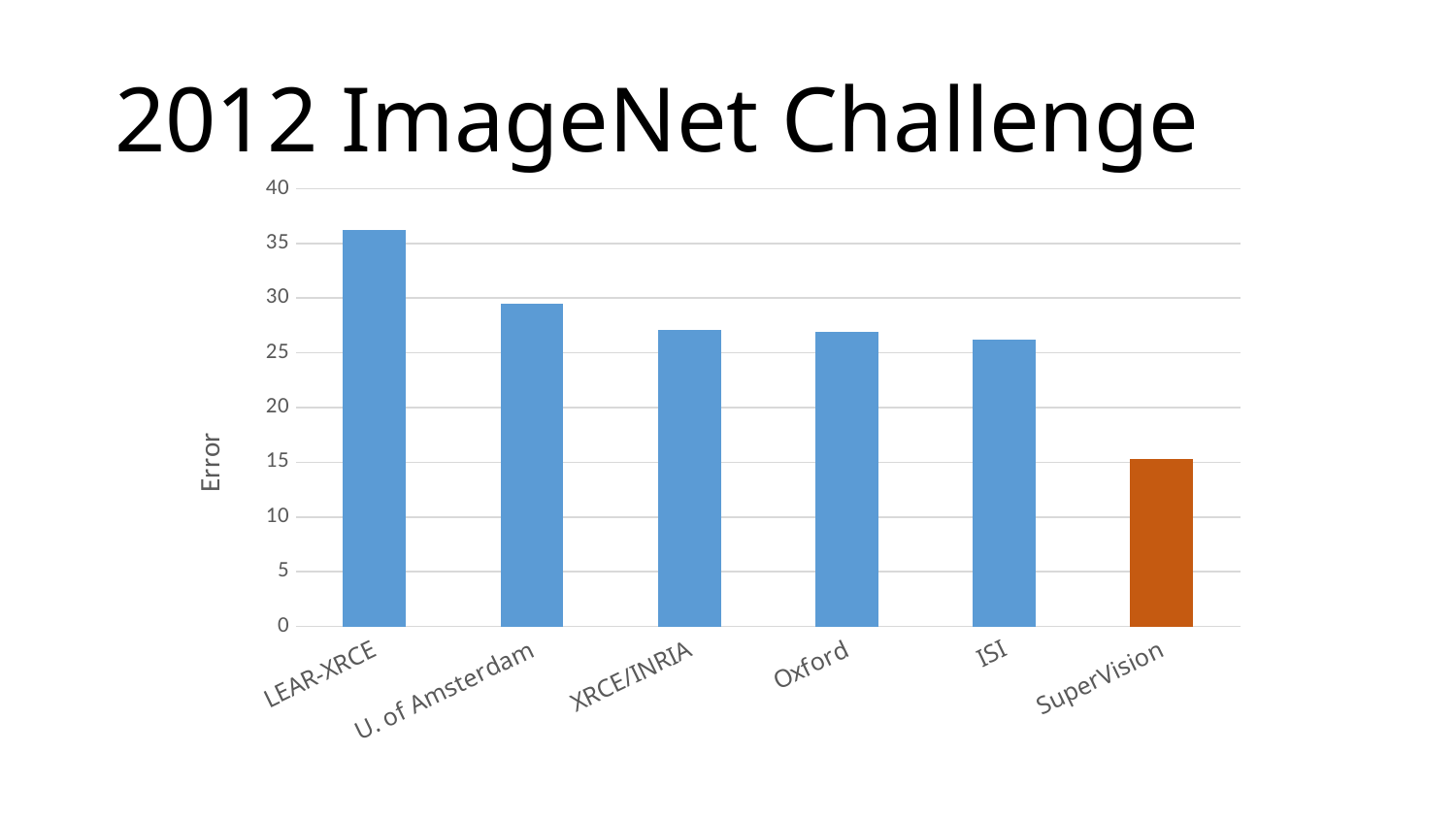
What kind of chart is shown on the slide? bar chart Which team has the lowest error? SuperVision Which bar is shown in a different colour (orange) from the others? SuperVision Is the error for SuperVision greater or less than 20? less What is the title of the chart? 2012 ImageNet Challenge How many teams (categories) are shown on the x axis? 6 Which has a lower error, ISI or SuperVision? SuperVision Is the error for Oxford greater or less than 30? less Is the error for LEAR-XRCE greater or less than 35? greater Which has a higher error, LEAR-XRCE or U. of Amsterdam? LEAR-XRCE Which team has the highest error? LEAR-XRCE